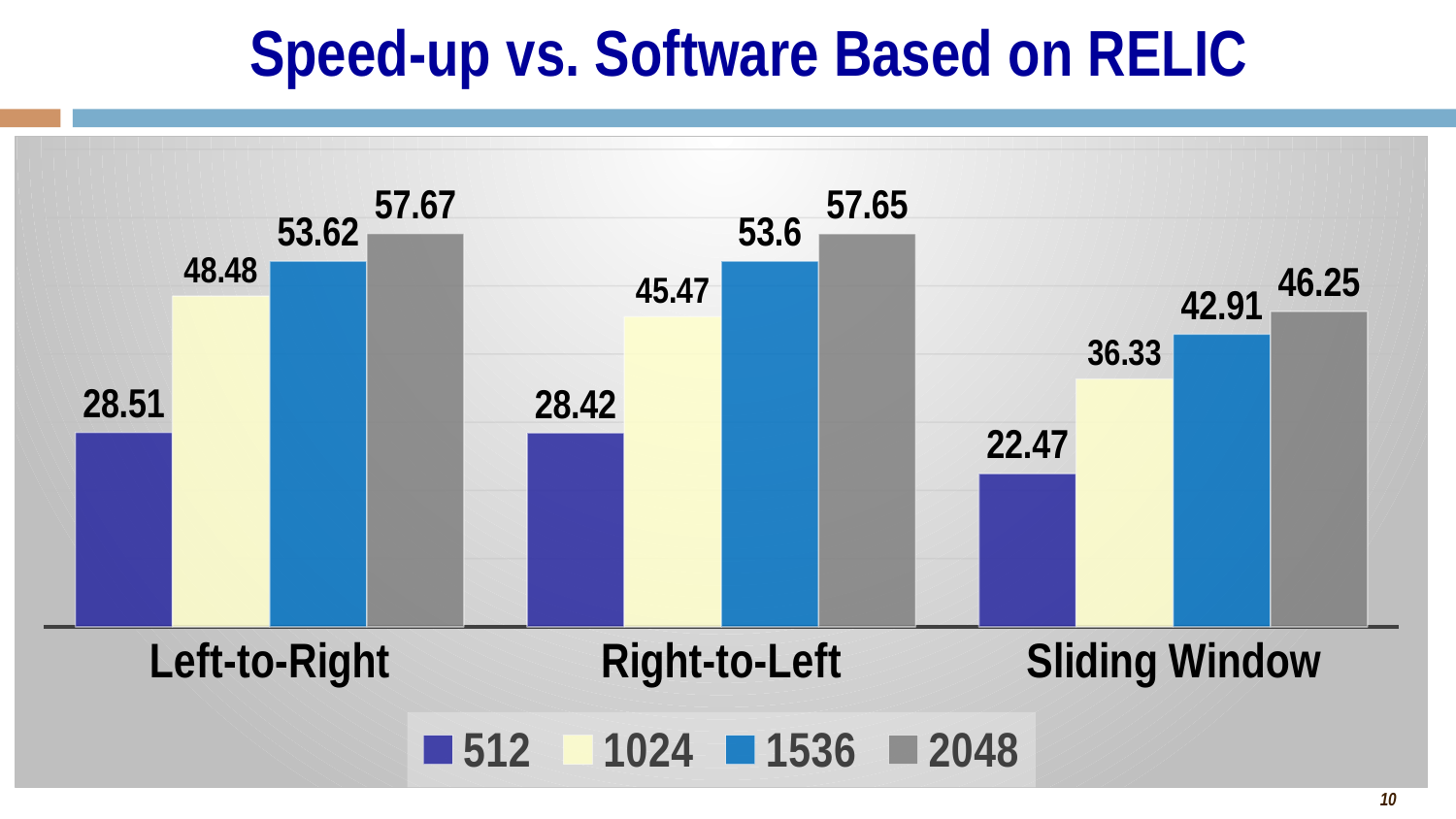
Which is larger: the 1024 value for Right-to-Left or the 1536 value for Sliding Window? 1024 value for Right-to-Left What is the value for the 2048 series in the Sliding Window category? 46.25 What is the title of the slide? Speed-up vs. Software Based on RELIC How many series does the legend list? 4 What is the difference between the 2048 and 512 values in the Left-to-Right category? 29.16 Which series has the highest value in the Right-to-Left category? 2048 What is the speed-up value for the 1024 series in the Left-to-Right category? 48.48 What kind of chart is shown on the slide? Bar chart What is the value for the 512 series in the Right-to-Left category? 28.42 How many categories are shown on the x axis? 3 Which category has the lowest value for the 1536 series? Sliding Window What is the difference between the 1536 values for Right-to-Left and Sliding Window? 10.69